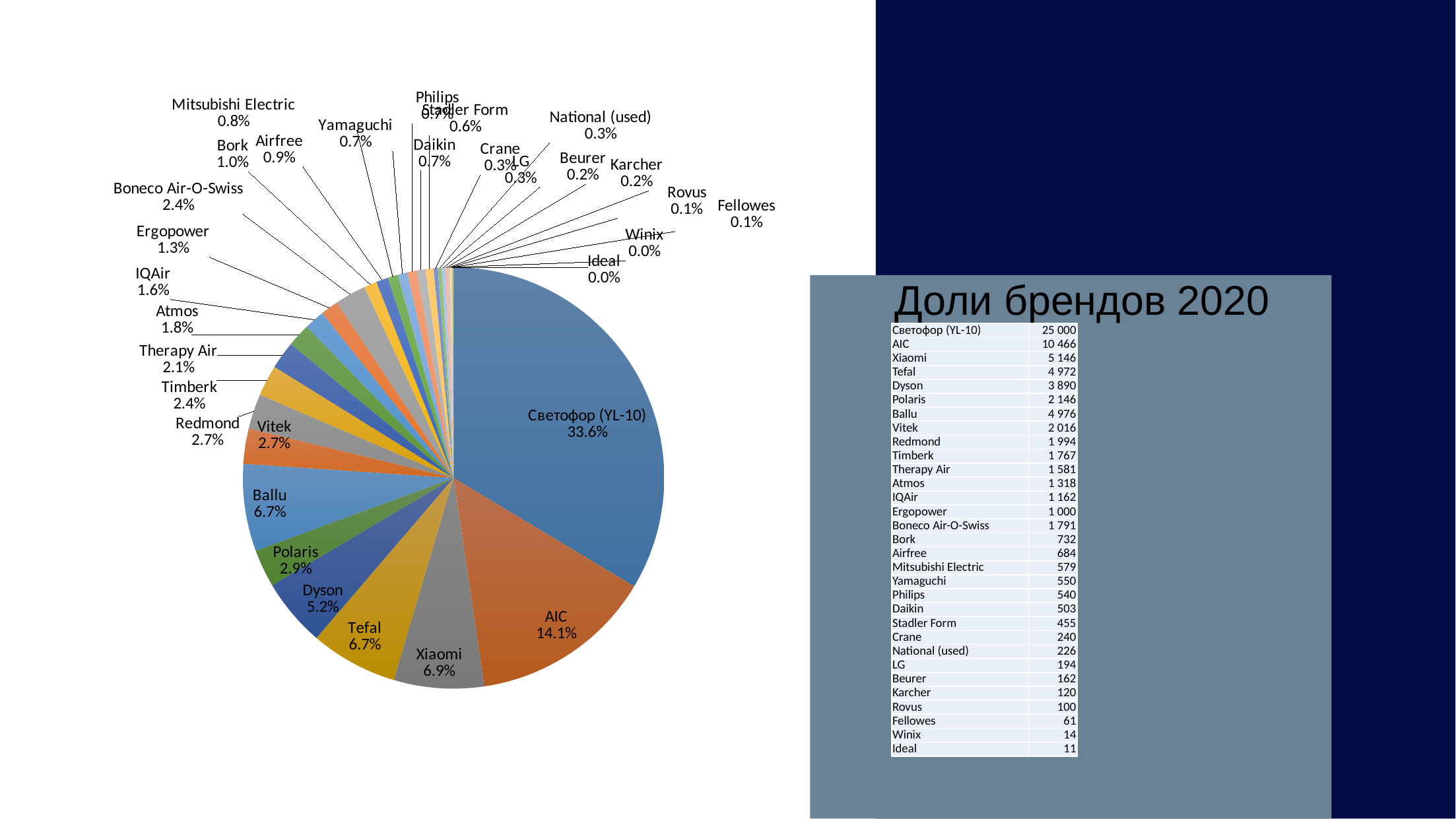
Which has the larger share in the pie chart, Ballu or Vitek? Ballu What percentage is shown for Dyson in the pie chart? 5.2% Which brand has the largest slice of the pie chart? Светофор (YL-10) What share of the pie does Светофор (YL-10) hold? 33.6% What percentage is shown for Xiaomi in the pie chart? 6.9% What percentage is shown for Boneco Air-O-Swiss in the pie chart? 2.4% By how many percentage points does Светофор (YL-10) exceed AIC in the pie chart? 19.5 percentage points What percentage is shown for AIC in the pie chart? 14.1% What is the title shown on the slide for the brand share data? Доли брендов 2020 Which has the larger share in the pie chart, Dyson or Polaris? Dyson What kind of chart is shown on the slide? Pie chart How many brands (slices) are shown in the pie chart? 31